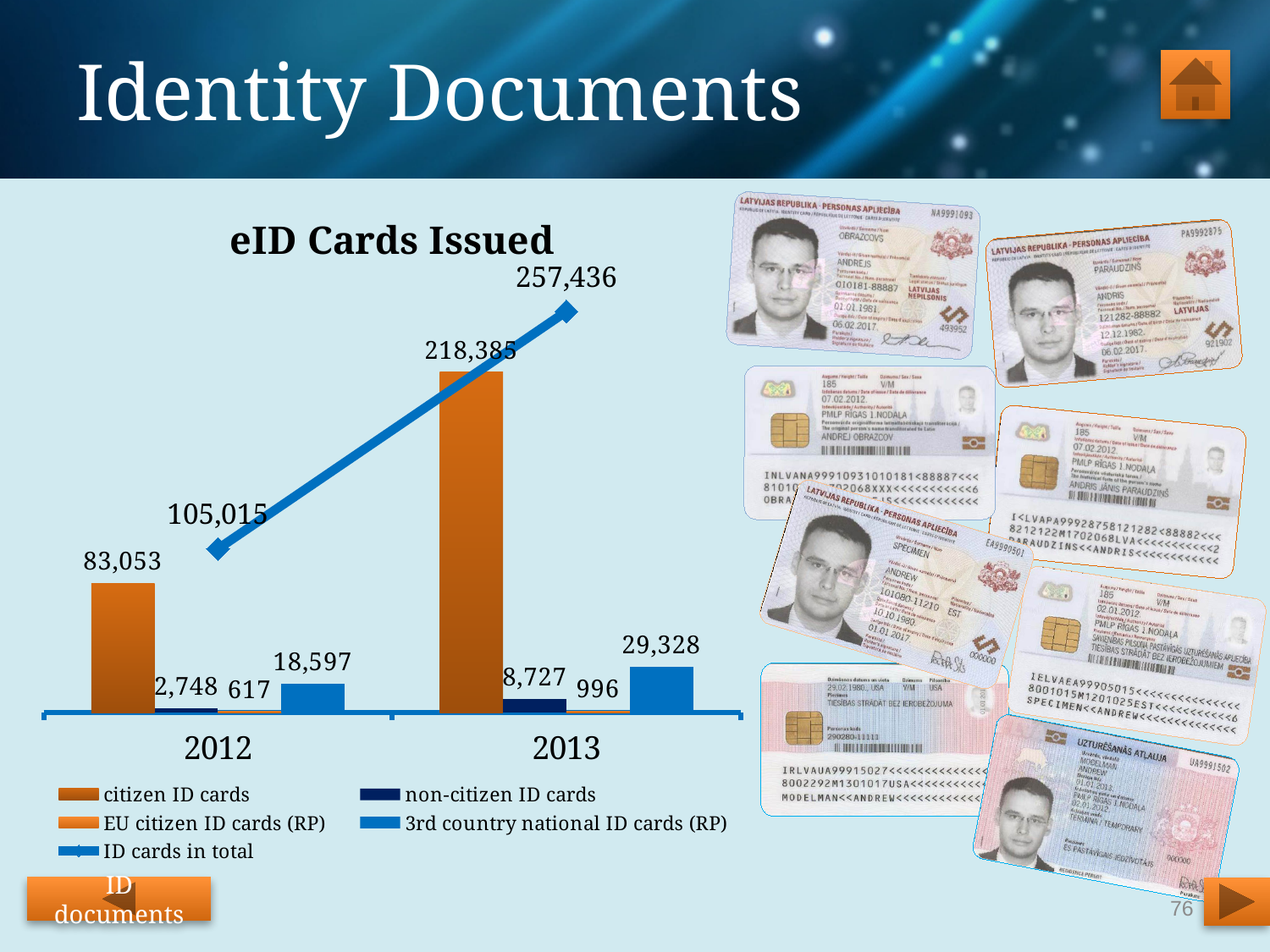
What is the difference between ID cards in total for 2013 and 2012? 152,421 What is the value for non-citizen ID cards in 2013? 8,727 How many years are shown on the x axis of the chart? 2 What is the value of ID cards in total for 2013? 257,436 Does the ID cards in total line rise or fall from 2012 to 2013? rise Which series has the lowest value in 2012? EU citizen ID cards (RP) How many series does the chart legend list? 5 What is the title of the chart on the slide? eID Cards Issued What is the value for citizen ID cards in 2013? 218,385 What is the value for citizen ID cards in 2012? 83,053 What is the value for EU citizen ID cards (RP) in 2012? 617 What is the value for 3rd country national ID cards (RP) in 2013? 29,328